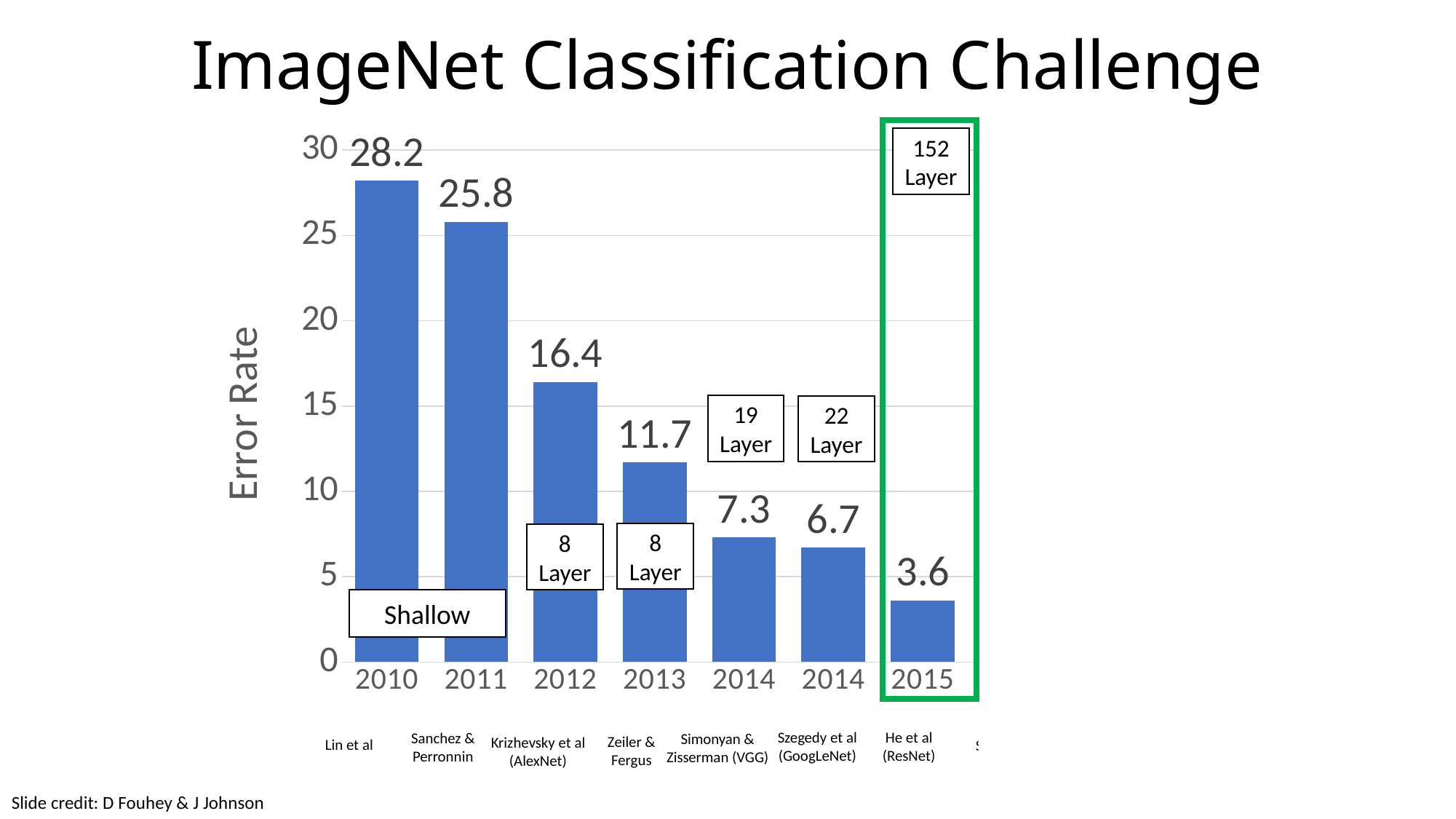
What is the error rate for 2015 (He et al, ResNet)? 3.6 Which year has the lowest error rate? 2015 Which year has the highest error rate? 2010 What is the difference in error rate between 2011 and 2012? 9.4 What kind of chart is shown on the slide? Bar chart What is the difference in error rate between 2013 and 2015? 8.1 What is the label on the vertical axis of the chart? Error Rate What is the error rate for 2010? 28.2 Which has a higher error rate, Simonyan & Zisserman (VGG) or Szegedy et al (GoogLeNet)? Simonyan & Zisserman (VGG) Does the error rate rise or fall from 2010 to 2015? Fall How many bars are shown in the chart? 7 What is the error rate for 2012 (Krizhevsky et al, AlexNet)? 16.4